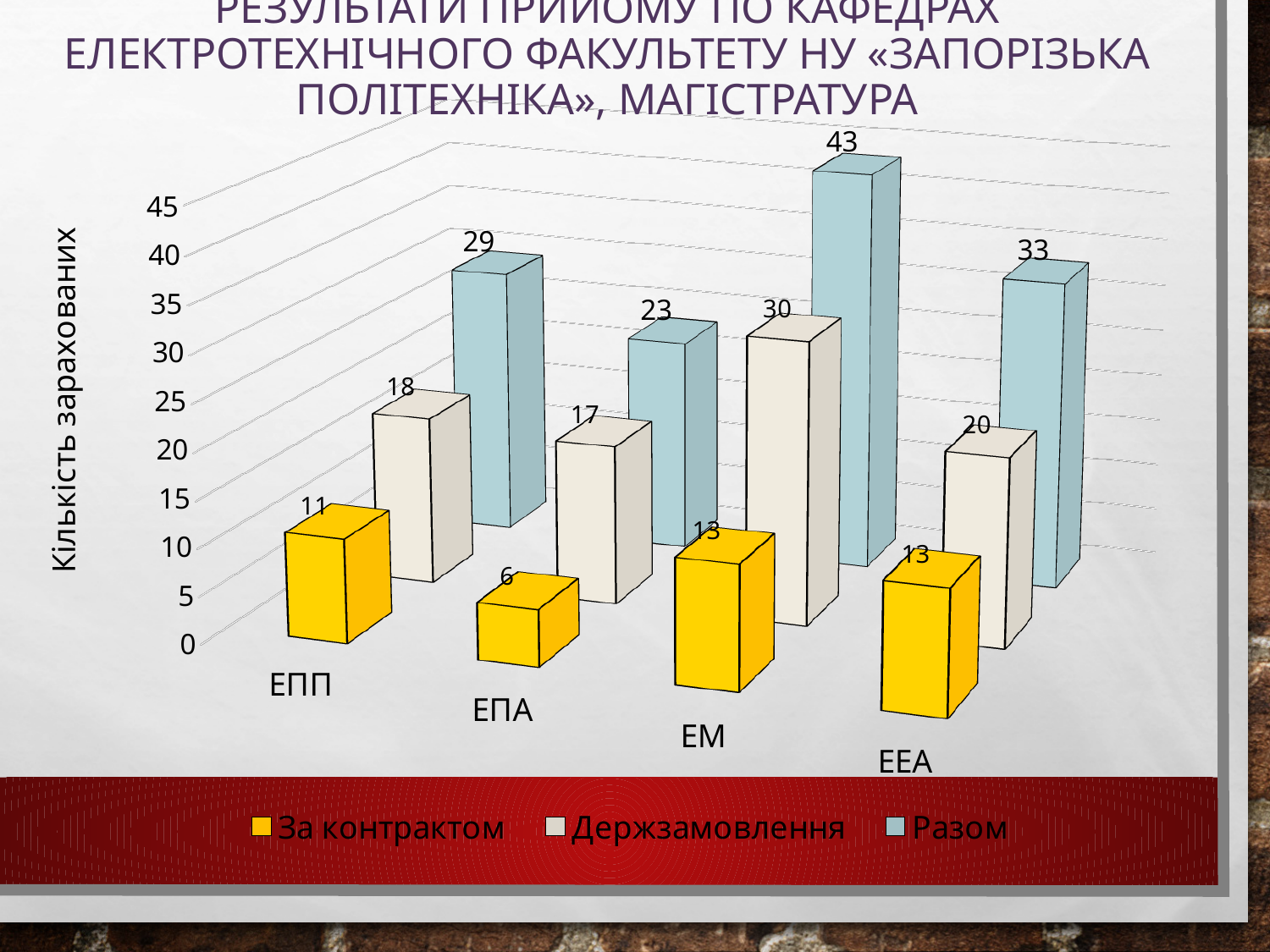
What is the value of «Держзамовлення» for ЕЕА? 20 What is the difference between the «Держзамовлення» values for ЕМ and ЕПП? 12 What is the label of the vertical axis? Кількість зарахованих How many categories (departments) are shown on the x axis? 4 Is the «Держзамовлення» value for ЕПА greater or less than 20? less Which department has the lowest «За контрактом» value? ЕПА Which is larger: the «Разом» value for ЕПП or for ЕЕА? ЕЕА What is the value of «За контрактом» for ЕПА? 6 How many series does the legend list? 3 Which department has the highest «Разом» value? ЕМ What is the value of «Разом» for ЕМ? 43 What type of chart is shown on the slide? bar chart